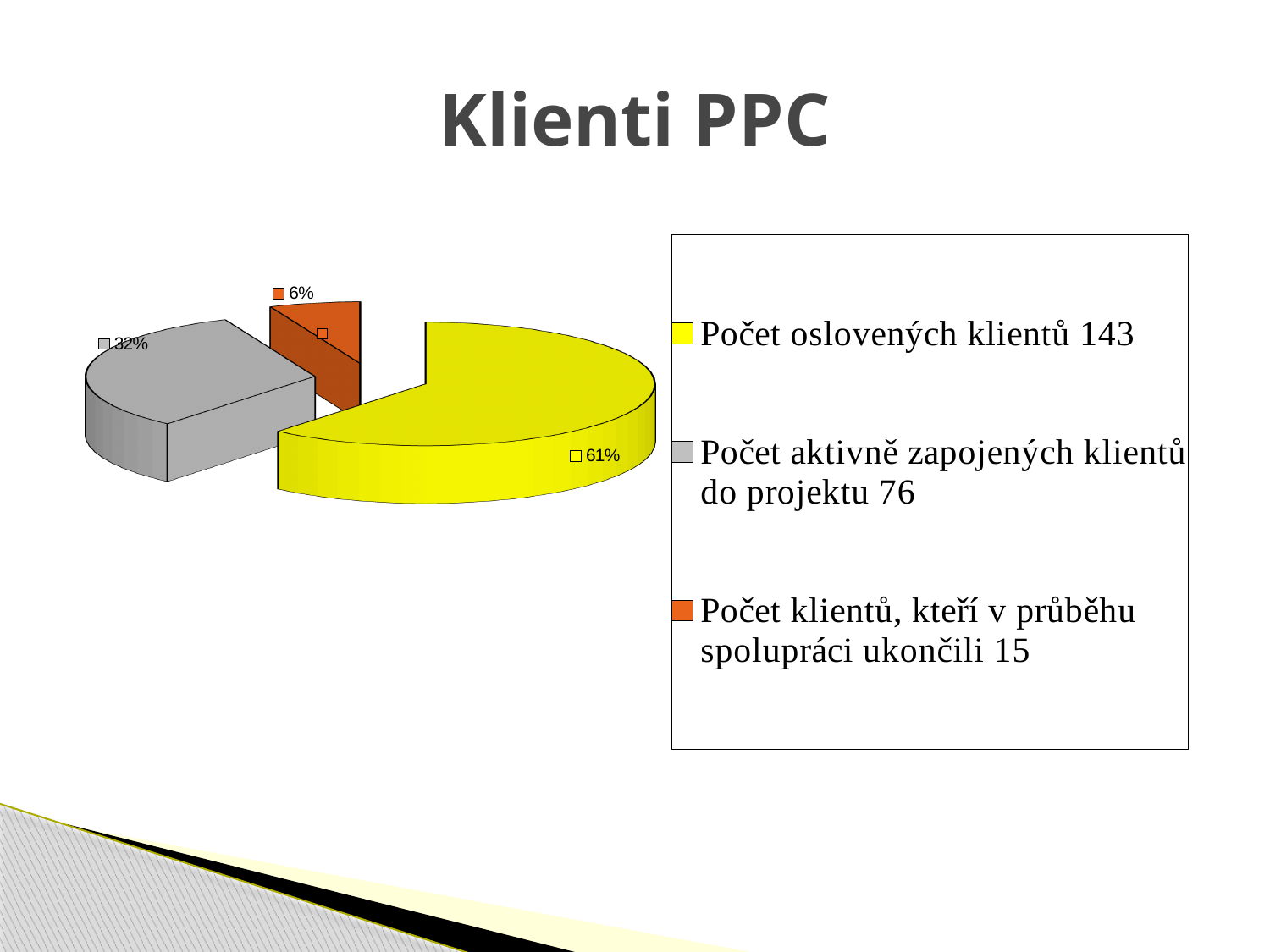
Which category has the largest slice of the pie? Počet oslovených klientů Which category has the smallest slice of the pie? Počet klientů, kteří v průběhu spolupráci ukončili What is the difference in percentage points between the 61% slice and the 32% slice? 29 percentage points What share of the pie does the slice for "Počet oslovených klientů" represent? 61% How many slices does the pie chart have? 3 Which slice is larger: "Počet aktivně zapojených klientů do projektu" or "Počet klientů, kteří v průběhu spolupráci ukončili"? Počet aktivně zapojených klientů do projektu What colour is the slice for "Počet oslovených klientů"? Yellow What percentage is shown for the slice "Počet aktivně zapojených klientů do projektu"? 32% What kind of chart is shown on the slide? Pie chart What percentage is shown for the slice "Počet klientů, kteří v průběhu spolupráci ukončili"? 6% What is the title of the slide containing the chart? Klienti PPC How many entries does the legend list? 3